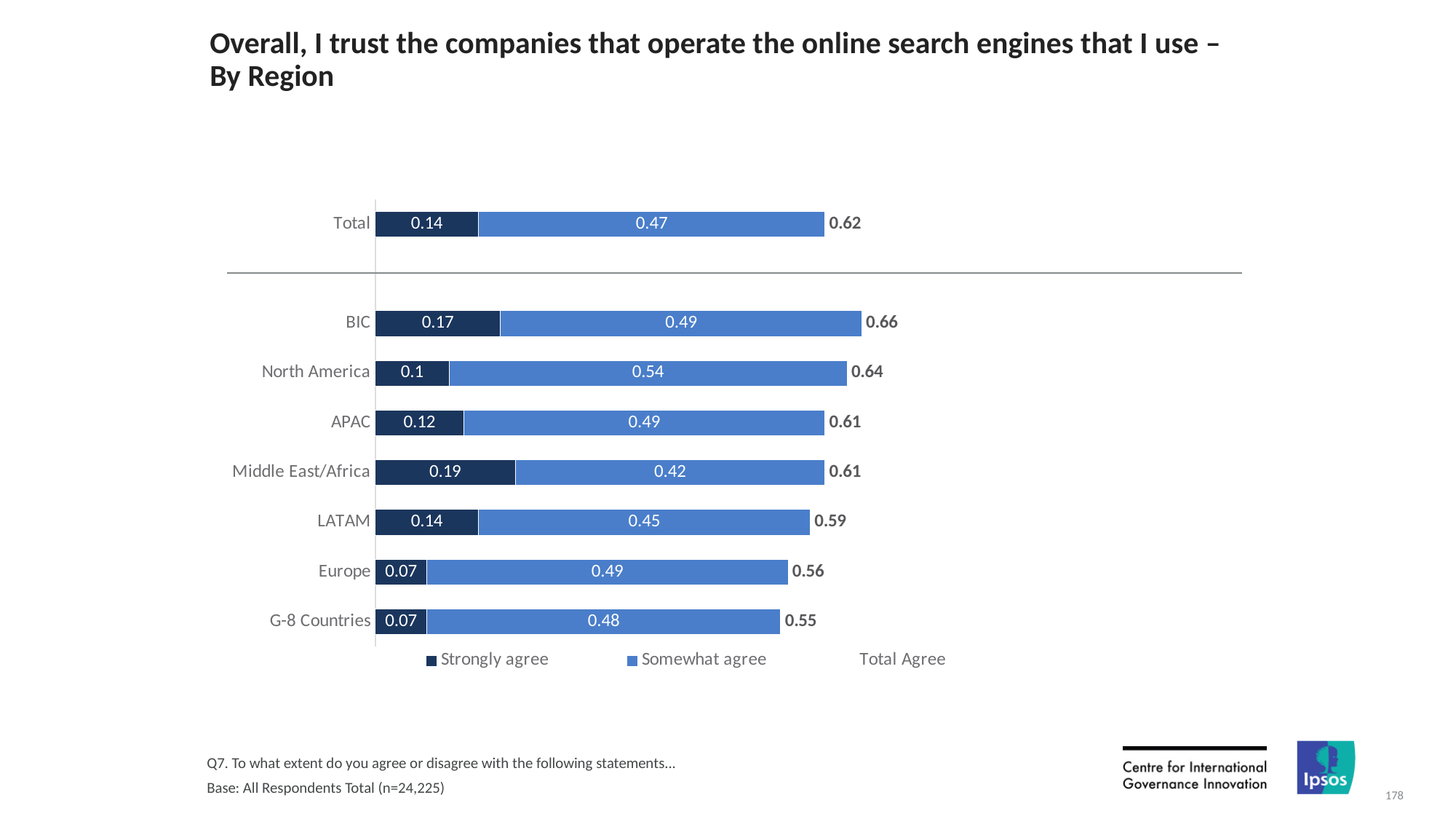
Which is larger, the Strongly agree value for BIC or for APAC? BIC What is the Total Agree value for the Total bar? 0.62 What is the Somewhat agree value for North America? 0.54 Which region has the highest Strongly agree value? Middle East/Africa What is the difference between the Total Agree values for BIC and G-8 Countries? 0.11 Which region has the lowest Total Agree value? G-8 Countries Which region has the highest Total Agree value? BIC What kind of chart is shown on the slide? Stacked bar chart How many entries does the legend list? 3 What is the Strongly agree value for Middle East/Africa? 0.19 How many regions are shown below the Total bar? 7 What is the Total Agree value for Europe? 0.56